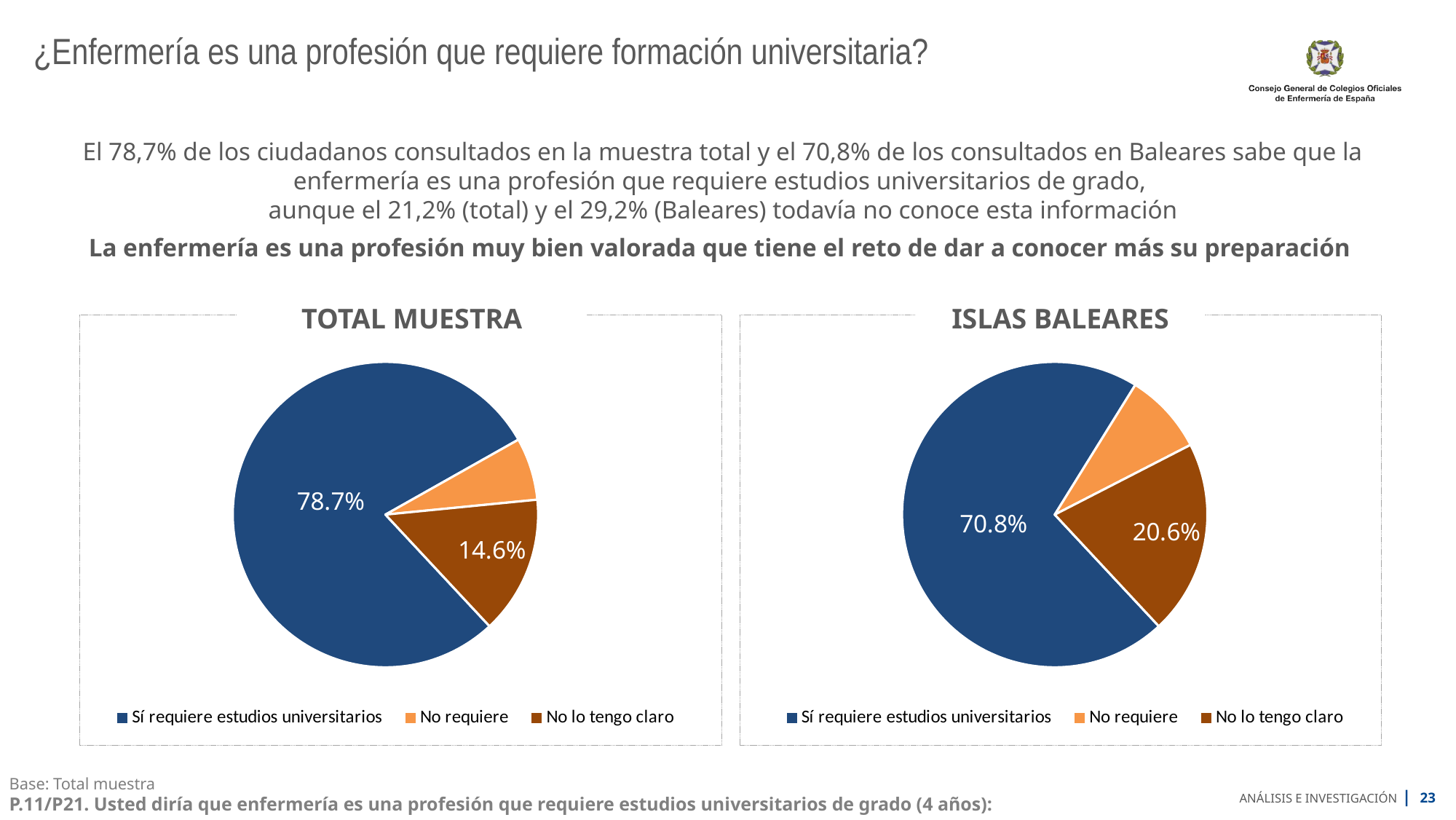
In the TOTAL MUESTRA chart, what percentage is shown for 'No lo tengo claro'? 14.6% In the TOTAL MUESTRA chart, what is the difference between 'Sí requiere estudios universitarios' and 'No lo tengo claro'? 64.1% In the ISLAS BALEARES chart, what is the difference between 'Sí requiere estudios universitarios' and 'No lo tengo claro'? 50.2% In the ISLAS BALEARES chart, what percentage is shown for 'Sí requiere estudios universitarios'? 70.8% Which chart shows a larger share for 'Sí requiere estudios universitarios', TOTAL MUESTRA or ISLAS BALEARES? TOTAL MUESTRA How many slices does the ISLAS BALEARES pie chart have? 3 What type of chart is used for ISLAS BALEARES? Pie chart In the ISLAS BALEARES chart, what percentage is shown for 'No lo tengo claro'? 20.6% In the TOTAL MUESTRA chart, which category has the largest slice? Sí requiere estudios universitarios In the TOTAL MUESTRA chart, what percentage is shown for 'Sí requiere estudios universitarios'? 78.7% In the ISLAS BALEARES chart, which category has the smallest slice? No requiere How many entries does the legend of the TOTAL MUESTRA chart list? 3